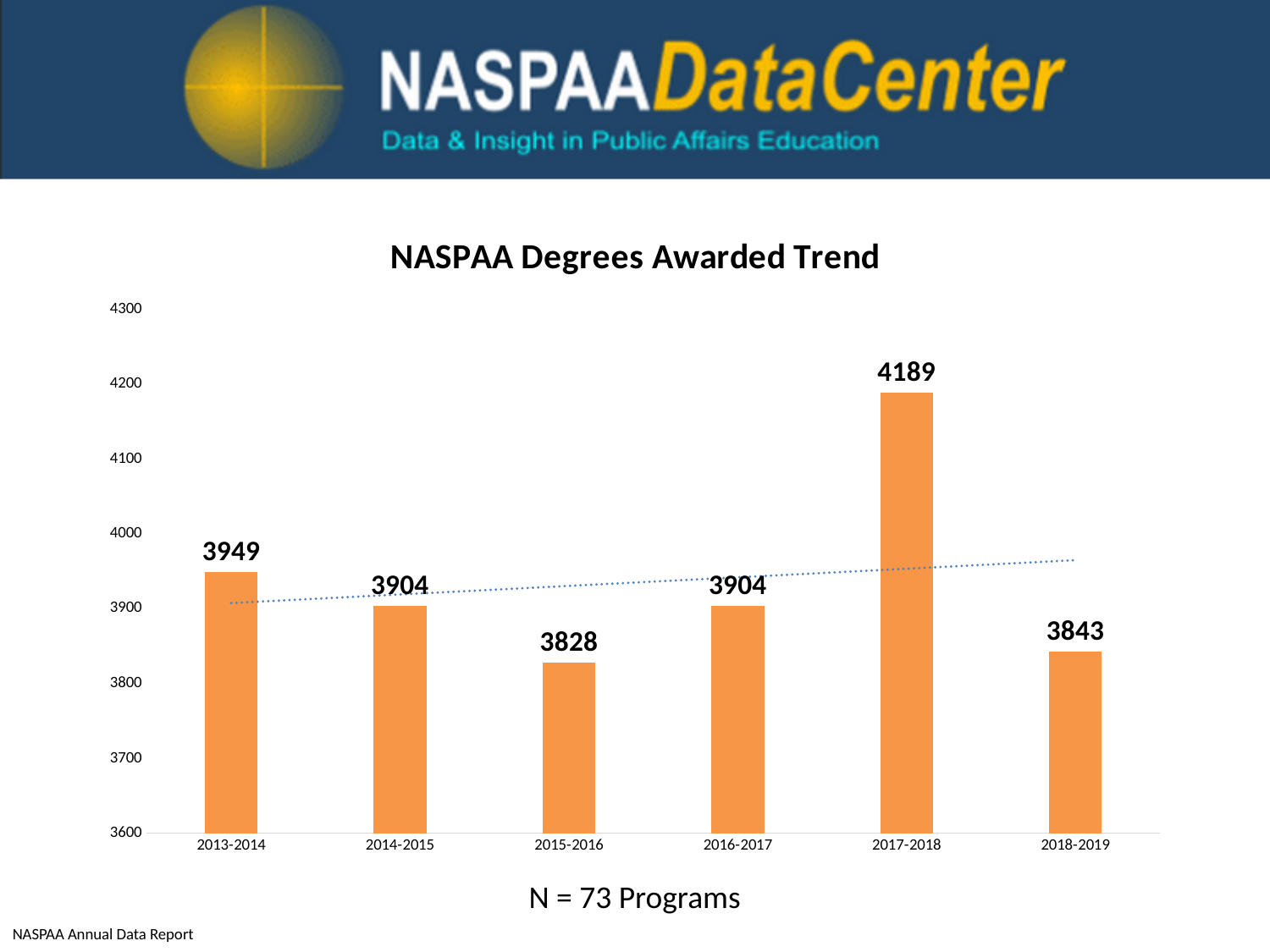
Which year has the lowest number of degrees awarded? 2015-2016 Which year has the highest number of degrees awarded? 2017-2018 What is the value for 2018-2019? 3843 What is the difference between the values for 2013-2014 and 2015-2016? 121 Is the value for 2015-2016 greater or less than 3900? less How many years are shown on the x axis? 6 What is the difference between the values for 2017-2018 and 2018-2019? 346 What is the value for 2013-2014? 3949 What is the value for 2017-2018? 4189 Which is larger, the value for 2013-2014 or the value for 2016-2017? 2013-2014 What kind of chart is this? bar chart What is the title of the chart? NASPAA Degrees Awarded Trend